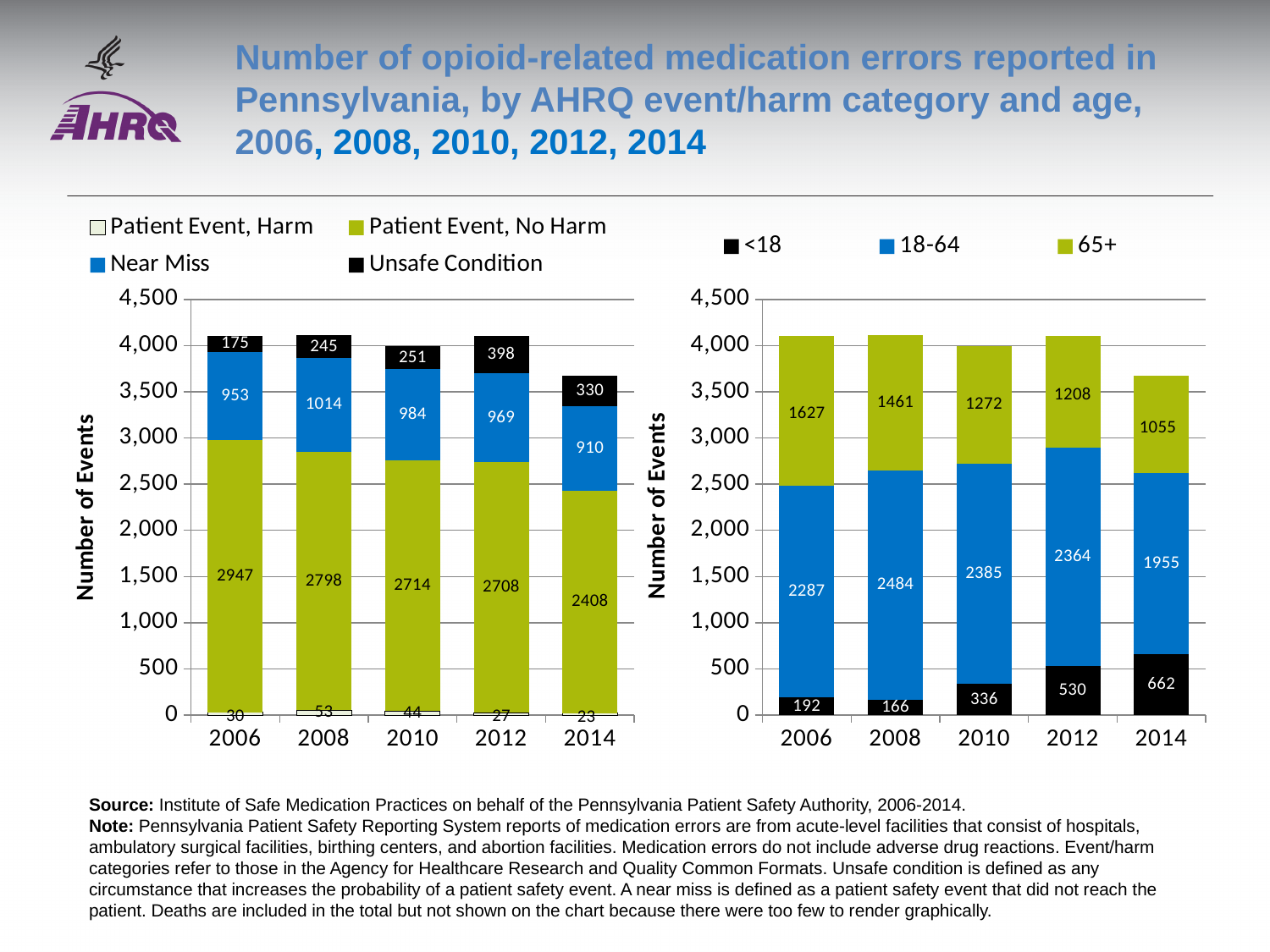
In the right chart (by age), which group has the larger value in 2006: 18-64 or 65+? 18-64 In the right chart (by age), do the values for the 65+ group rise or fall from 2006 to 2014? fall In the right chart (by age), which year has the highest value for the 18-64 group? 2008 In the left chart (by AHRQ event/harm category), what is the Near Miss value for 2010? 984 In the left chart (by AHRQ event/harm category), how much larger is the Unsafe Condition value in 2012 than in 2006? 223 What is the y-axis title of the right chart (by age)? Number of Events In the left chart (by AHRQ event/harm category), which year has the lowest Patient Event, No Harm value? 2014 How many series does the legend of the right chart (by age) list? 3 How many years are shown on the x axis of the left chart (by AHRQ event/harm category)? 5 What kind of chart is the left chart (by AHRQ event/harm category)? stacked bar chart In the right chart (by age), do the values for the <18 group rise or fall from 2008 to 2014? rise In the right chart (by age), what is the value for the <18 group in 2014? 662